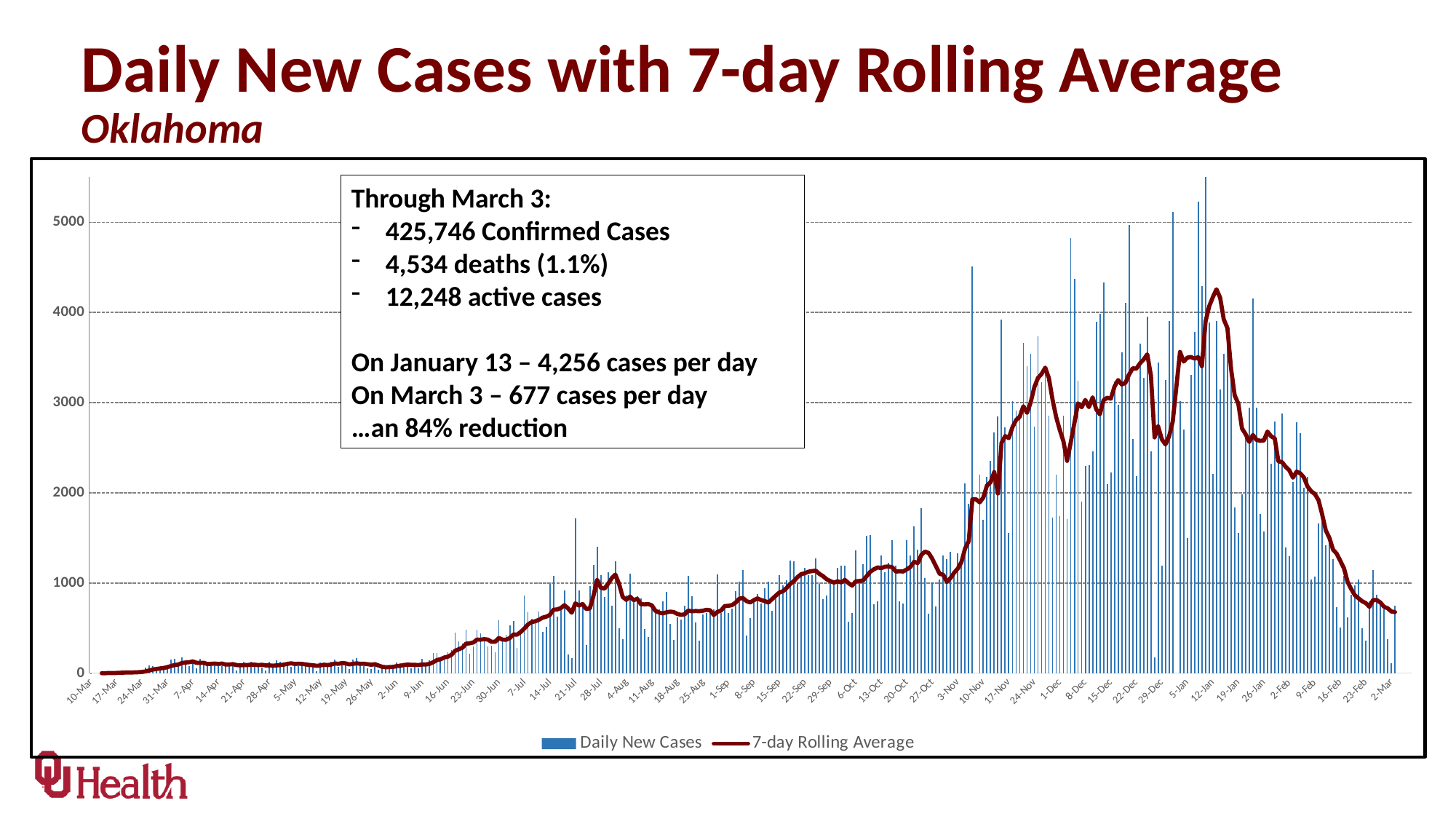
How many series does the chart legend list? 2 Does the 7-day rolling average rise or fall between 12-Jan and 2-Mar? fall According to the slide, how many cases per day were there on January 13? 4,256 What is the title of the chart on the slide? Daily New Cases with 7-day Rolling Average According to the slide, how many cases per day were there on March 3? 677 What are the two series named in the chart legend? Daily New Cases and 7-day Rolling Average Is the 7-day rolling average around 12-Jan greater or less than 4000? greater Is the 7-day rolling average around 1-Sep greater or less than 1000? less Which is larger, the 7-day rolling average around 12-Jan or around 2-Mar? 12-Jan What percentage reduction in cases per day does the slide report between January 13 and March 3? 84% What kind of chart is shown on the slide? A bar chart with a line overlay Is the 7-day rolling average around 2-Mar greater or less than 1000? less